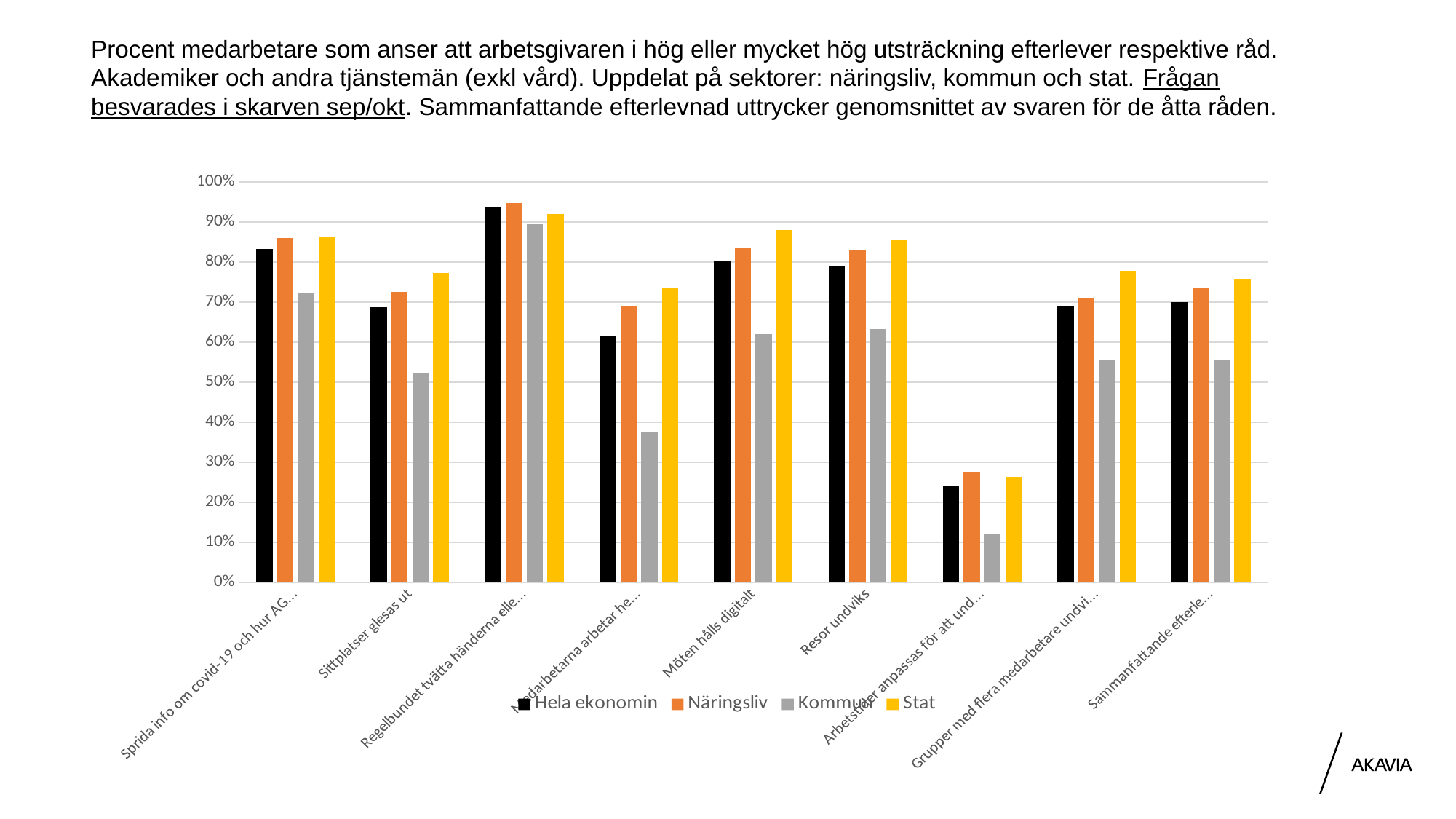
Which series has the lowest value for "Sittplatser glesas ut"? Kommun What kind of chart is shown on the slide? bar chart How many category groups are plotted along the x axis? 9 Is the Stat value for "Möten hålls digitalt" greater or less than 80%? greater Which series has the lowest value for "Resor undviks"? Kommun For "Sittplatser glesas ut", which is larger: the Hela ekonomin value or the Näringsliv value? Näringsliv Is the Kommun value for "Sittplatser glesas ut" greater or less than 60%? less Is the Näringsliv value for "Resor undviks" greater or less than 80%? greater How many series does the legend list? 4 What colour are the bars for the Stat series? yellow Which series has the highest value for "Möten hålls digitalt"? Stat